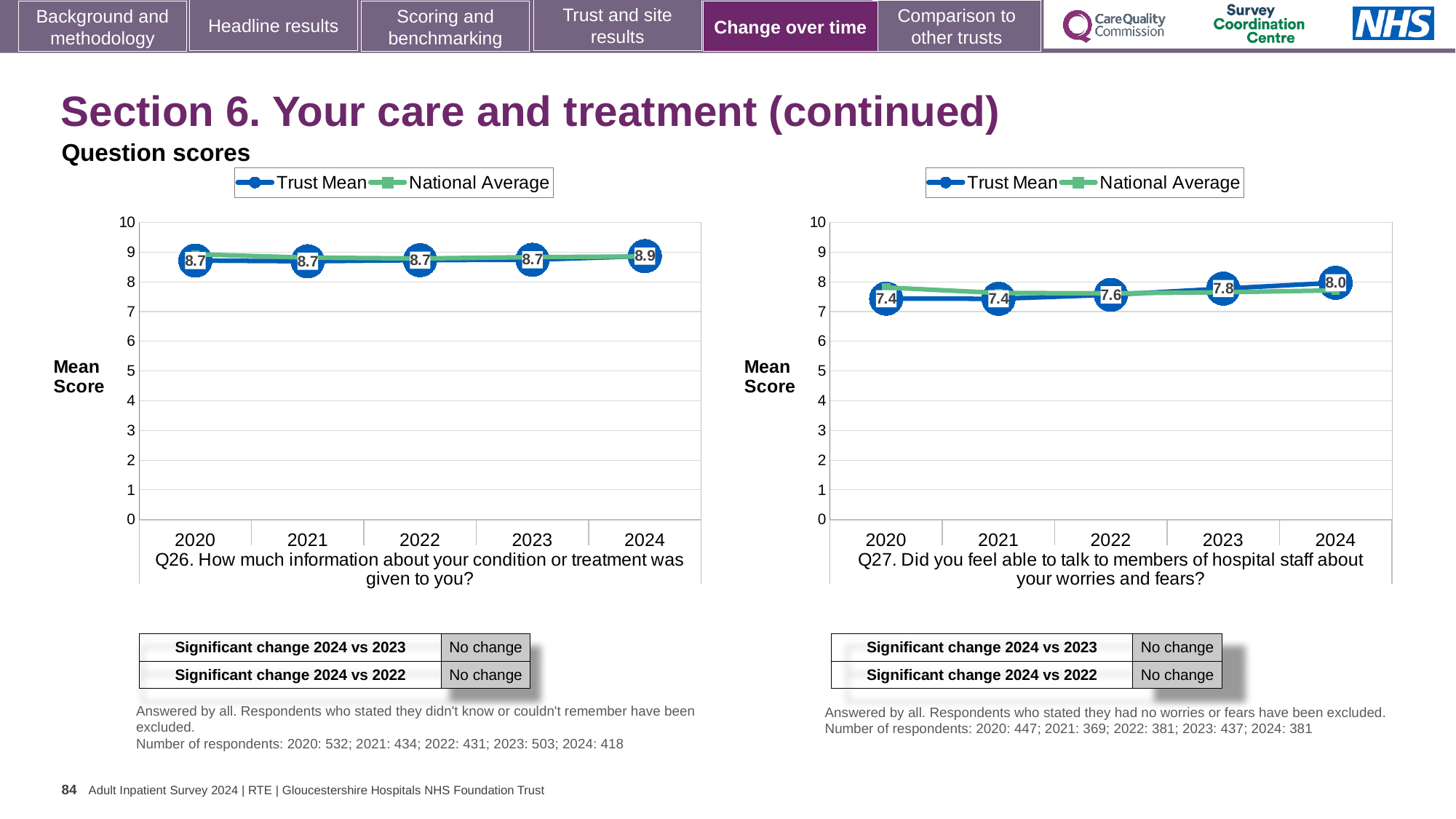
In the Q27 chart on the right, is the Trust Mean score for 2023 larger or smaller than the score for 2021? larger In the Q26 chart on the left, what is the difference between the Trust Mean scores for 2024 and 2023? 0.2 In the Q27 chart on the right, what is the Trust Mean score for 2020? 7.4 In the Q26 chart on the left, what is the Trust Mean score for 2024? 8.9 What kind of chart is the Q26 chart on the left? line chart In the Q27 chart on the right, which year has the highest Trust Mean score? 2024 How many years are plotted on the x axis of the Q26 chart on the left? 5 In the Q27 chart on the right, is the National Average value for 2020 greater or less than 7? greater In the Q27 chart on the right, what is the difference between the Trust Mean scores for 2024 and 2020? 0.6 In the Q27 chart on the right, what is the Trust Mean score for 2022? 7.6 How many series does the legend of the Q27 chart on the right list? 2 In the Q26 chart on the left, which year has the highest Trust Mean score? 2024